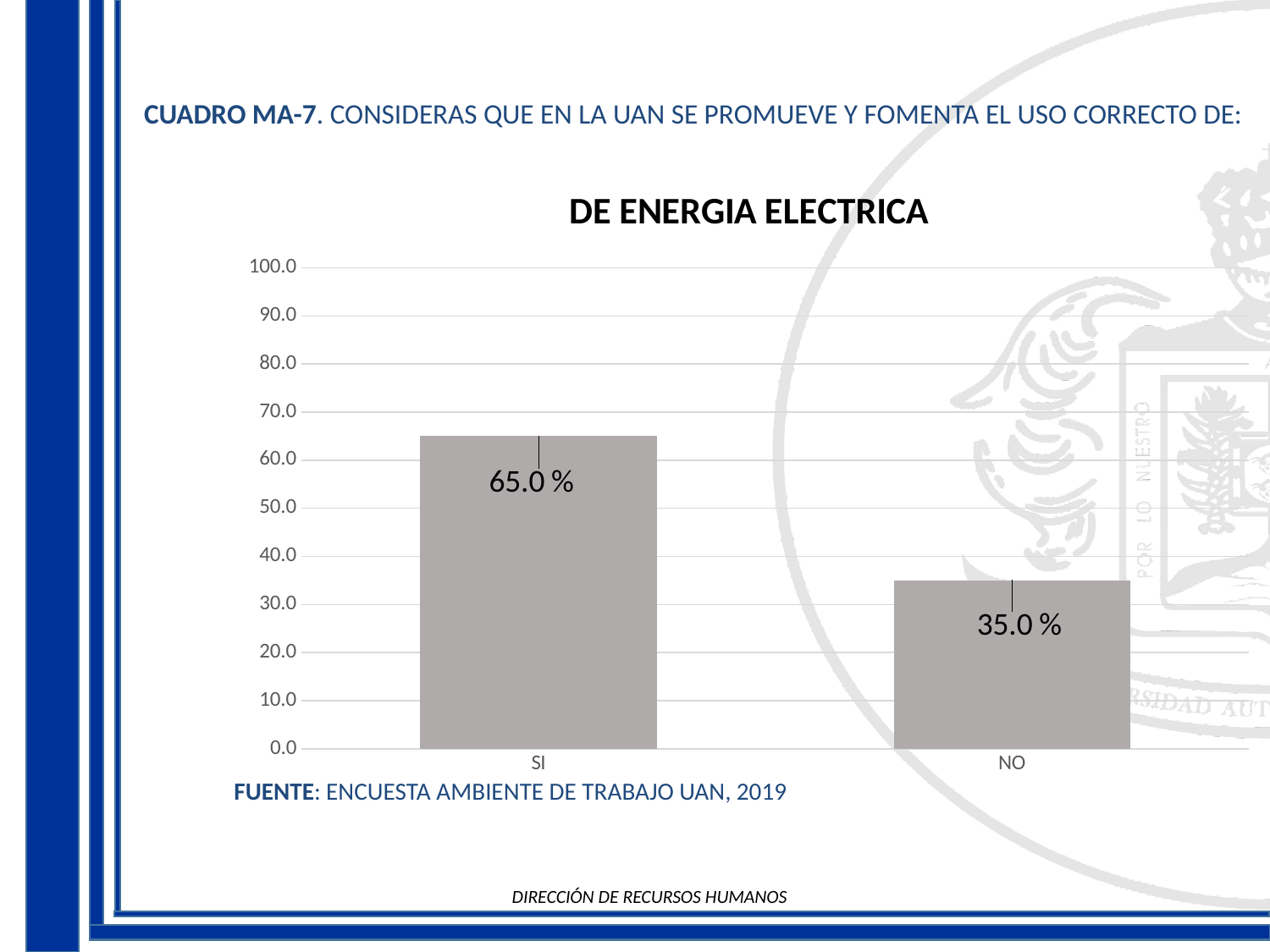
What is the value for SI? 65.0 % What is the difference between the values for SI and NO? 30.0 % How many categories are shown on the x axis? 2 Is the value for SI greater or less than 60.0? greater Which category has the highest value? SI Which category has the lowest value? NO What is the value for NO? 35.0 % What is the maximum value shown on the y axis? 100.0 Is the value for NO greater or less than 40.0? less Which is larger, the value for SI or the value for NO? SI What is the title of the chart? DE ENERGIA ELECTRICA What kind of chart is shown? bar chart